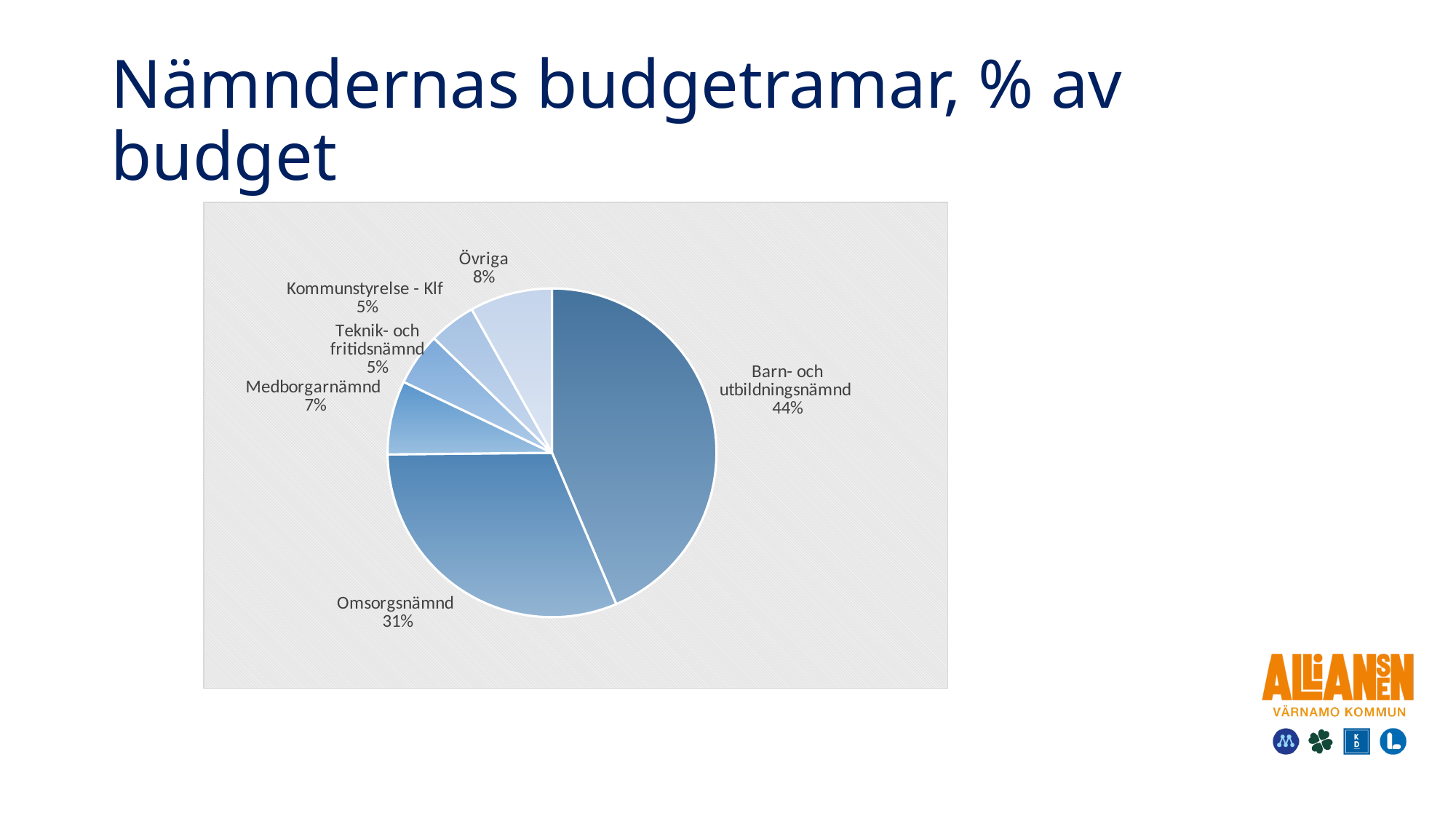
How many slices does the pie chart have? 6 Which category has the largest share of the budget? Barn- och utbildningsnämnd What share of the budget does Övriga have? 8% What share of the budget does Barn- och utbildningsnämnd have? 44% What type of chart is shown on the slide? pie chart Which has a larger share, Övriga or Medborgarnämnd? Övriga What is the title of the slide containing the chart? Nämndernas budgetramar, % av budget What share of the budget does Omsorgsnämnd have? 31% What is the difference in percentage points between Barn- och utbildningsnämnd and Omsorgsnämnd? 13 What share of the budget does Kommunstyrelse - Klf have? 5% What share of the budget does Medborgarnämnd have? 7% What is the combined share of Barn- och utbildningsnämnd and Omsorgsnämnd? 75%